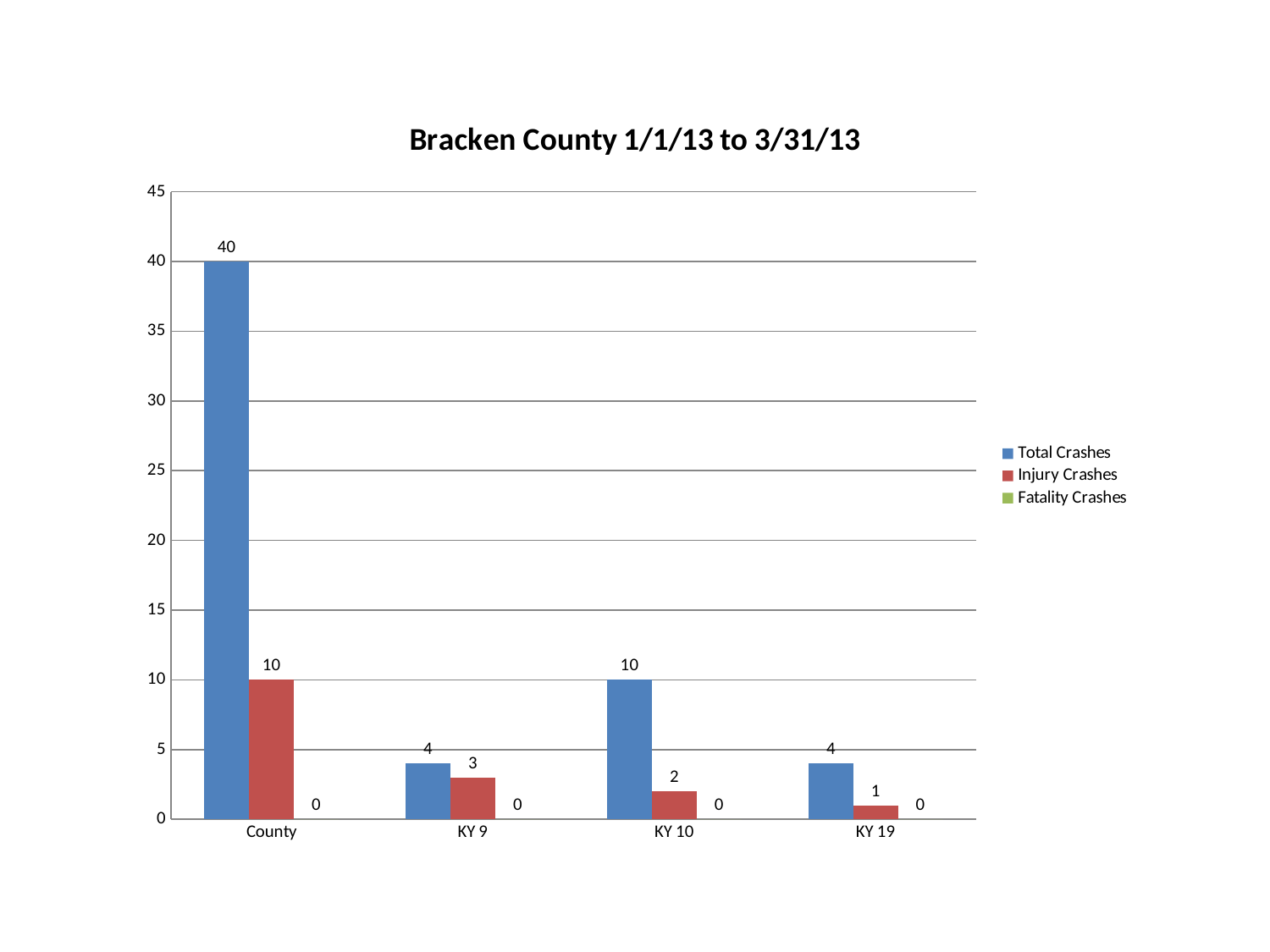
What is the value of Total Crashes for County? 40 What is the difference between Total Crashes and Injury Crashes for KY 10? 8 What is the title of the chart? Bracken County 1/1/13 to 3/31/13 Which category has the highest Total Crashes value? County How many categories are shown on the x axis? 4 What is the value of Injury Crashes for KY 9? 3 What kind of chart is shown on the slide? Bar chart What is the value of Fatality Crashes for KY 10? 0 Which series is shown in red? Injury Crashes How many series does the legend list? 3 Which category has the lowest Injury Crashes value? KY 19 Which is larger, Total Crashes for KY 10 or Total Crashes for KY 19? KY 10